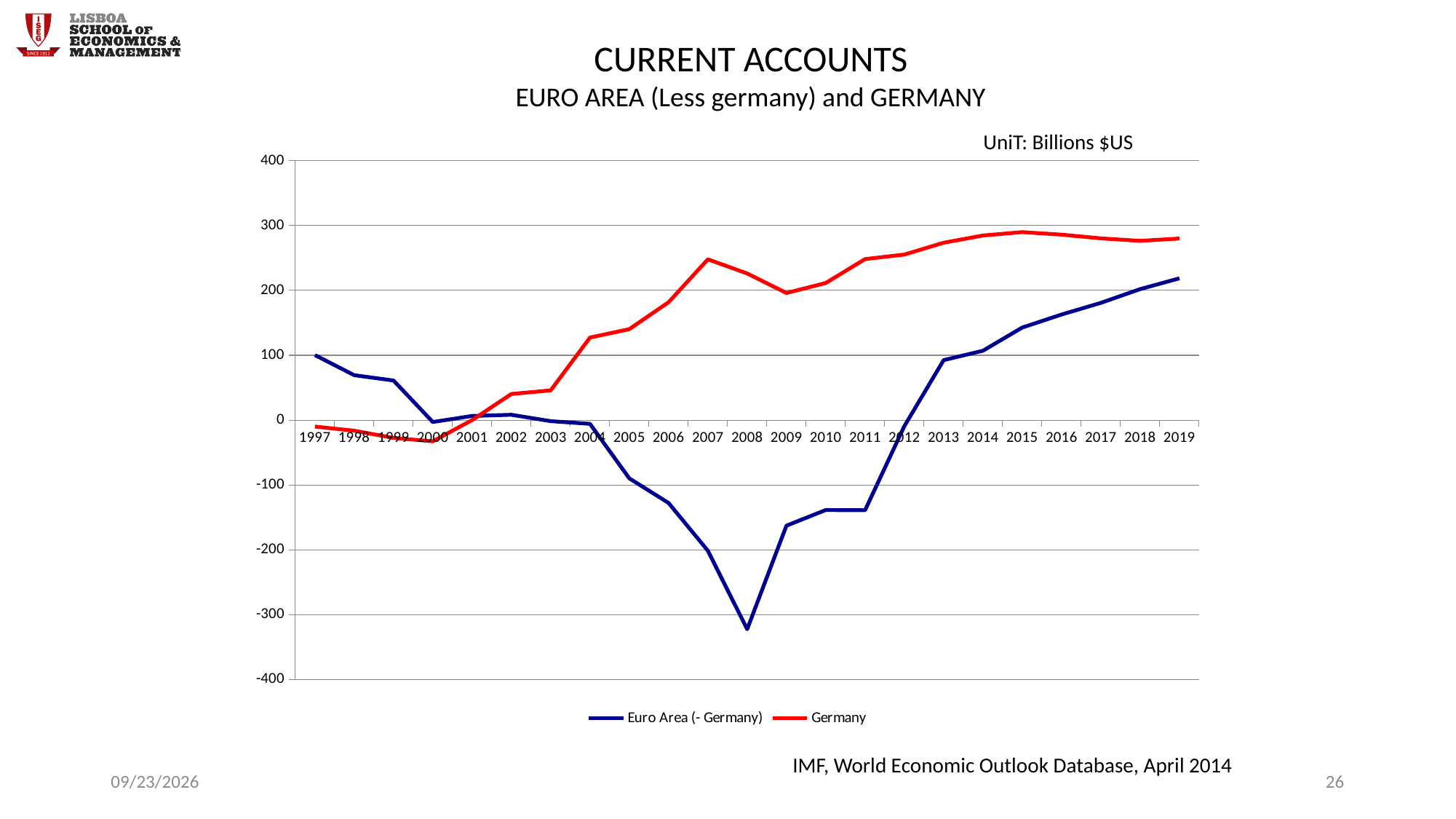
Is the value for Germany in 2007 greater or less than 200? greater In which year does the Germany series reach its lowest value? 2000 How many years are plotted along the x axis? 23 Which series has the larger value in 2010, Euro Area (- Germany) or Germany? Germany Is the value for Germany in 2002 greater or less than 100? less What kind of chart is shown on the slide? line chart How many series does the legend list? 2 In which year does the Euro Area (- Germany) series reach its lowest value? 2008 Is the value for Euro Area (- Germany) in 2008 greater or less than -300? less What unit is stated for the values in the chart? Billions $US Which series has the larger value in 1997, Euro Area (- Germany) or Germany? Euro Area (- Germany) In which year does the Euro Area (- Germany) series reach its highest value? 2019